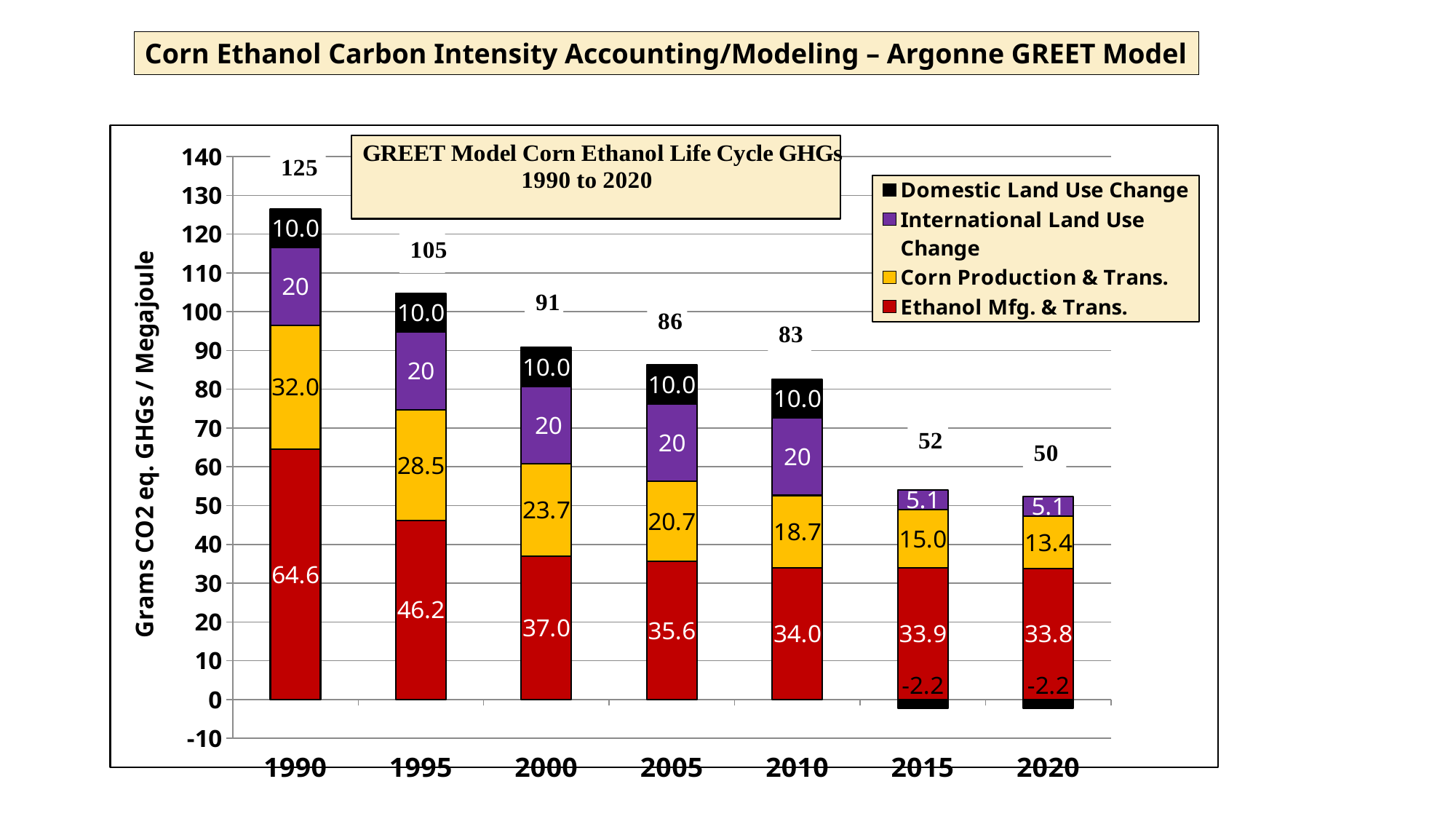
What is the total shown above the bar for 2000? 91 What kind of chart is shown? Stacked bar chart How many series does the legend list? 4 Which is larger, the Corn Production & Trans. value for 2010 or for 2015? 2010 What is the Corn Production & Trans. value for 2005? 20.7 Which year has the highest total life cycle GHGs? 1990 What is the difference between the Ethanol Mfg. & Trans. values for 1990 and 1995? 18.4 What is the Ethanol Mfg. & Trans. value for 1990? 64.6 What is the Domestic Land Use Change value for 2015? -2.2 What is the International Land Use Change value for 2020? 5.1 Which year has the lowest total life cycle GHGs? 2020 How many years are shown on the x axis? 7